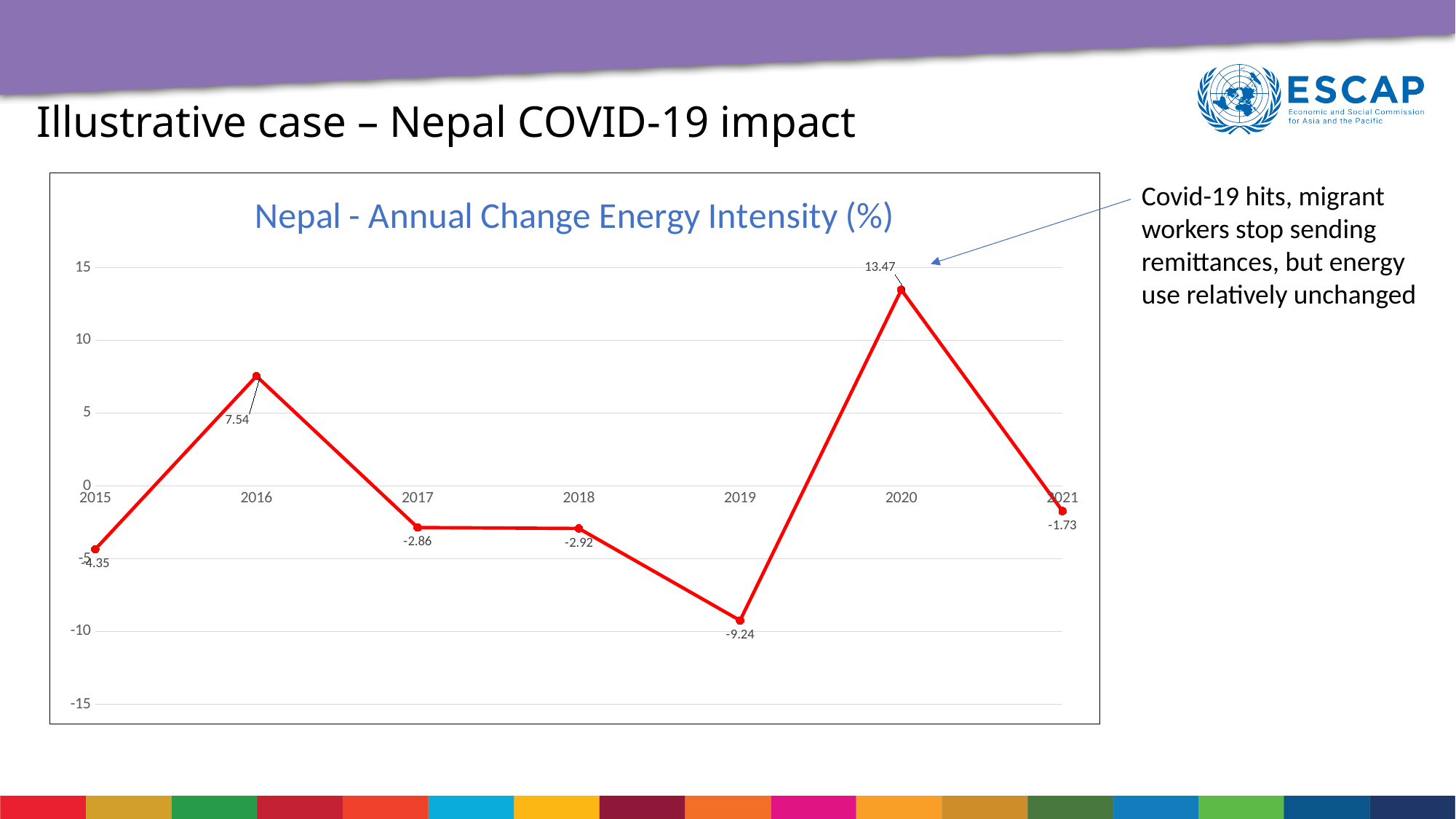
What is the value plotted for 2016? 7.54 What is the title of the chart? Nepal - Annual Change Energy Intensity (%) What is the annual change in energy intensity for Nepal in 2020? 13.47 Which year has the larger value, 2015 or 2017? 2017 What is the annual change in energy intensity for Nepal in 2019? -9.24 What type of chart is shown on the slide? Line chart What is the difference between the 2020 value and the 2016 value? 5.93 Does the value rise or fall from 2020 to 2021? Fall What is the value plotted for 2021? -1.73 Which year has the lowest annual change in energy intensity? 2019 Which year has the highest annual change in energy intensity? 2020 How many years are plotted on the chart? 7